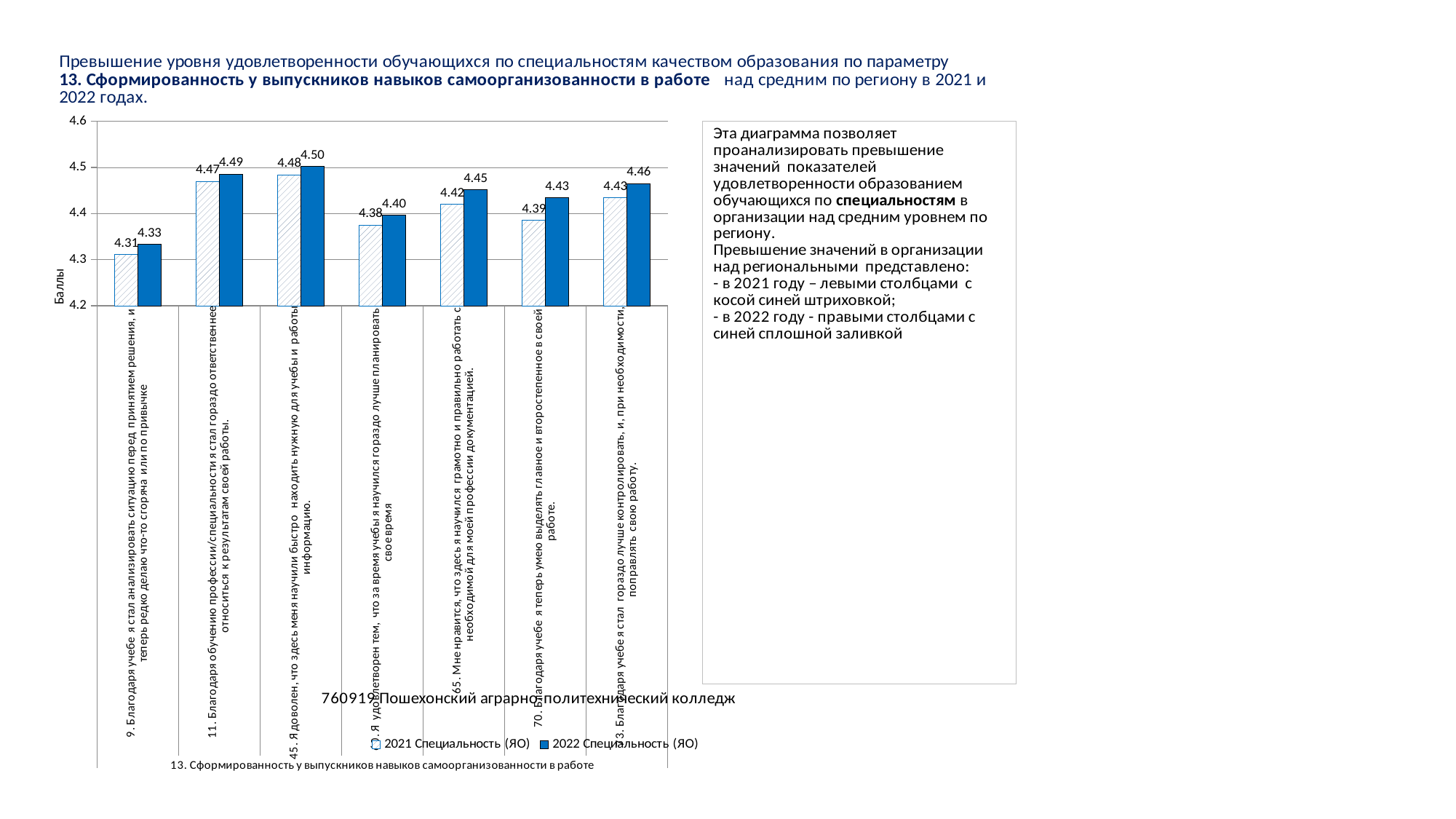
For the category beginning "70. Благодаря учебе я теперь умею выделять главное...", what is the difference between the 2022 and 2021 values? 0.04 What type of chart is shown on the slide? Bar chart What is the 2021 Специальность (ЯО) value for the category beginning "45. Я доволен, что здесь меня научили быстро находить нужную..."? 4.48 Which category has the highest 2022 Специальность (ЯО) value? 45. Я доволен, что здесь меня научили быстро находить нужную для учебы и работы информацию. What is the difference between the 2022 value for category 45 (4.50) and the 2022 value for category 9 (4.33)? 0.17 Which is larger: the 2021 value for the category beginning "11. Благодаря обучению профессии..." or the 2021 value for the category beginning "65. Мне нравится..."? 11. Благодаря обучению профессии/специальности я стал гораздо ответственнее относиться к результатам своей работы. What is the 2022 Специальность (ЯО) value for the category beginning "9. Благодаря учебе я стал анализировать ситуацию..."? 4.33 How many categories are shown on the x axis of the chart? 7 Which category has the lowest 2021 Специальность (ЯО) value? 9. Благодаря учебе я стал анализировать ситуацию перед принятием решения, и теперь редко делаю что-то сгоряча или по привычке What is the 2022 Специальность (ЯО) value for the category beginning "65. Мне нравится, что здесь я научился грамотно и правильно работать..."? 4.45 How many series does the chart legend list? 2 What are the two entries in the chart legend? 2021 Специальность (ЯО) and 2022 Специальность (ЯО)